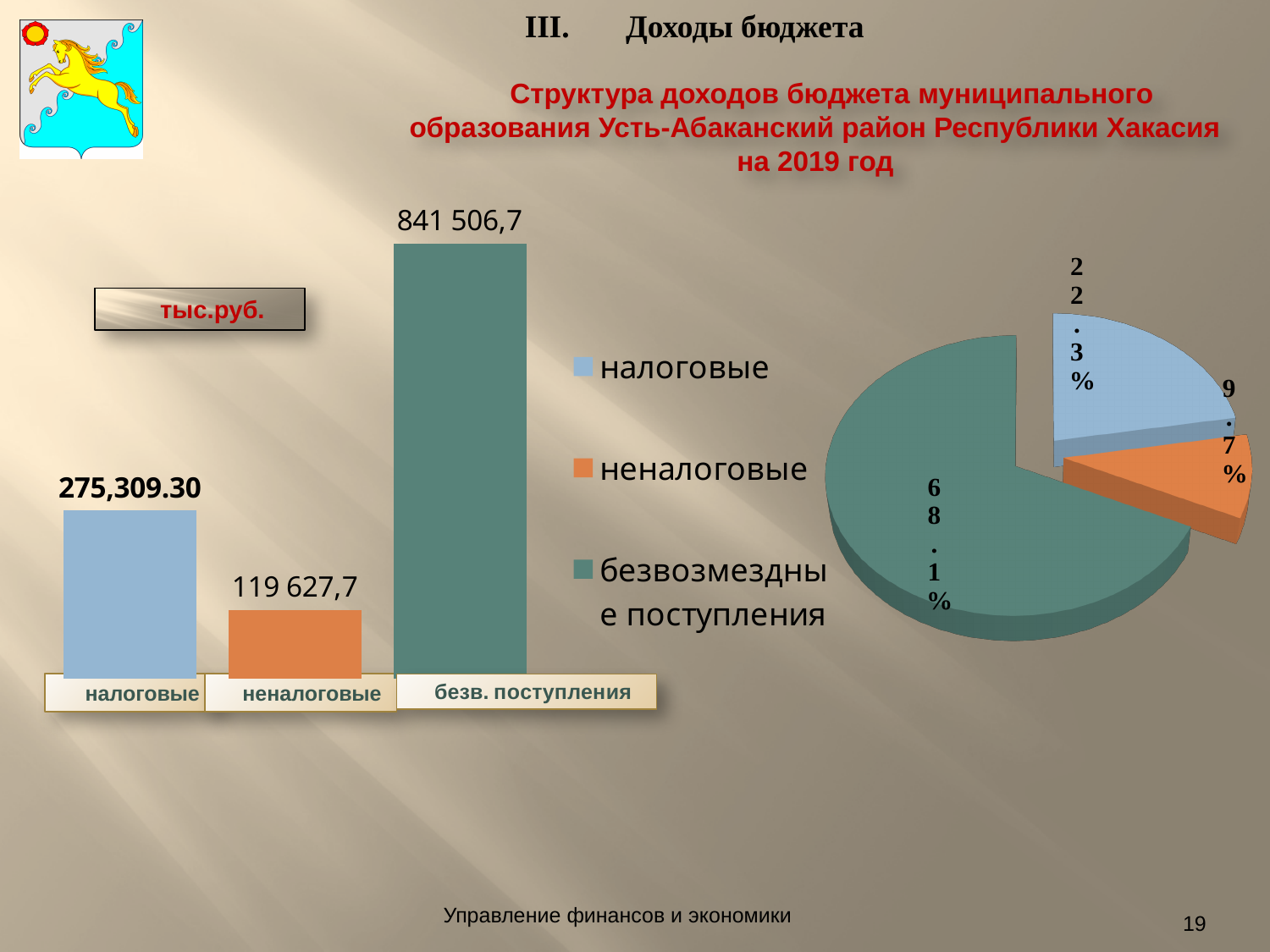
On the bar chart, which is larger: налоговые or неналоговые? налоговые How many bars are on the bar chart? 3 On the bar chart, what is the value for неналоговые? 119 627,7 How many entries does the legend between the two charts list? 3 On the pie chart, what share does the налоговые slice have? 22.3% On the bar chart, which category has the lowest value? неналоговые What kind of chart is on the left side of the slide? bar chart On the bar chart, what is the difference between безв. поступления and неналоговые? 721 879,0 On the bar chart, which category has the highest value? безв. поступления On the bar chart, what is the value for безв. поступления? 841 506,7 On the bar chart, what is the value for налоговые? 275,309.30 On the pie chart, what share does the безвозмездные поступления slice have? 68.1%